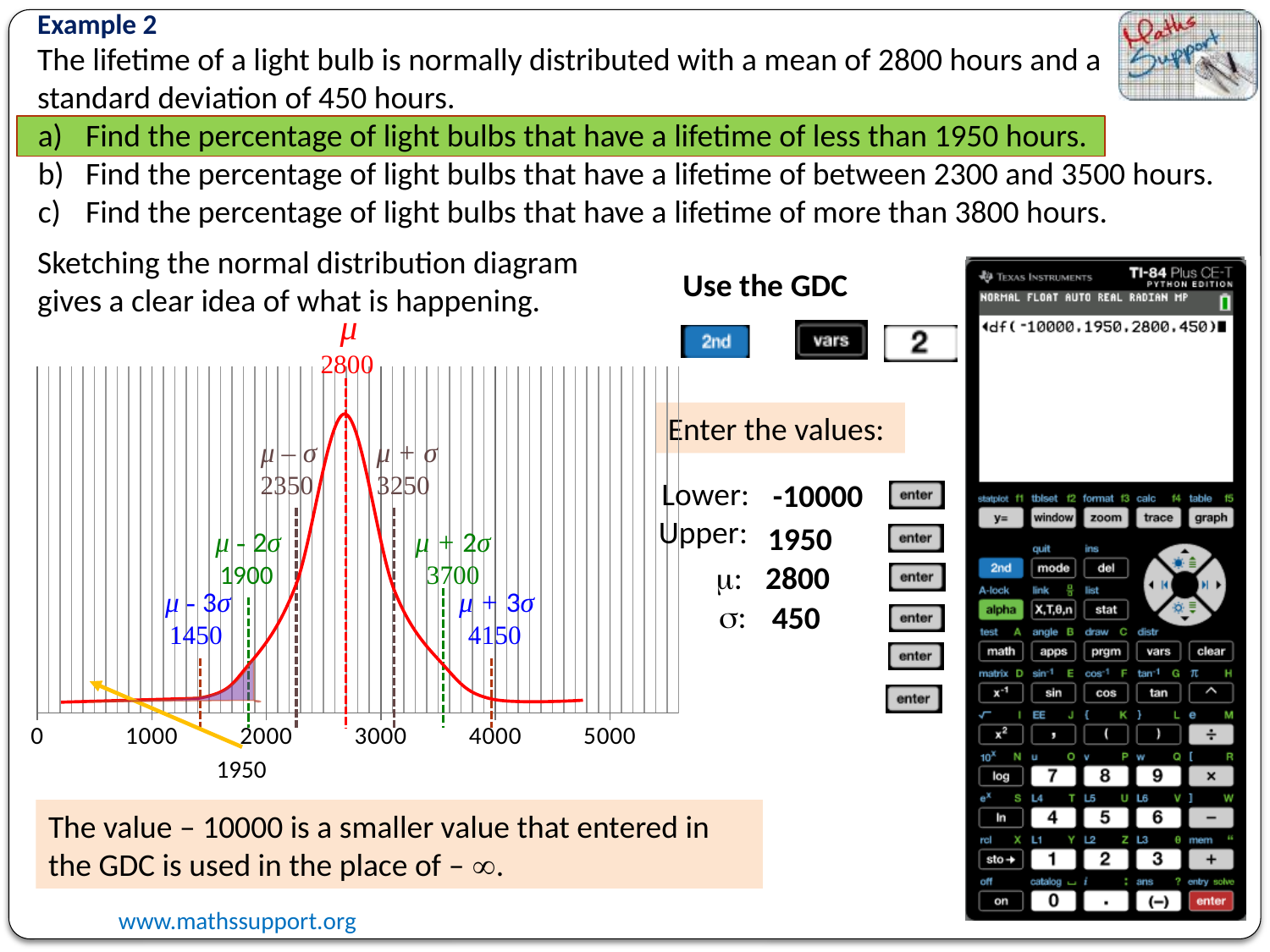
What value is labelled at μ − 2σ on the normal distribution sketch? 1900 What value is marked by the yellow arrow below the x axis of the sketch? 1950 Does the curve rise or fall as x increases from 2800 to 4000? fall What kind of chart is the normal distribution sketch? line chart What is the difference between the values labelled at μ + σ and μ − σ on the sketch? 900 What value is labelled at μ + 3σ on the normal distribution sketch? 4150 Is the value labelled at μ + 2σ greater or less than 3000? greater What value is labelled at the mean μ on the normal distribution sketch? 2800 What value is labelled at μ + σ on the normal distribution sketch? 3250 At which labelled x value does the curve reach its highest point? 2800 What value is labelled at μ − 3σ on the normal distribution sketch? 1450 What value is labelled at μ − σ on the normal distribution sketch? 2350